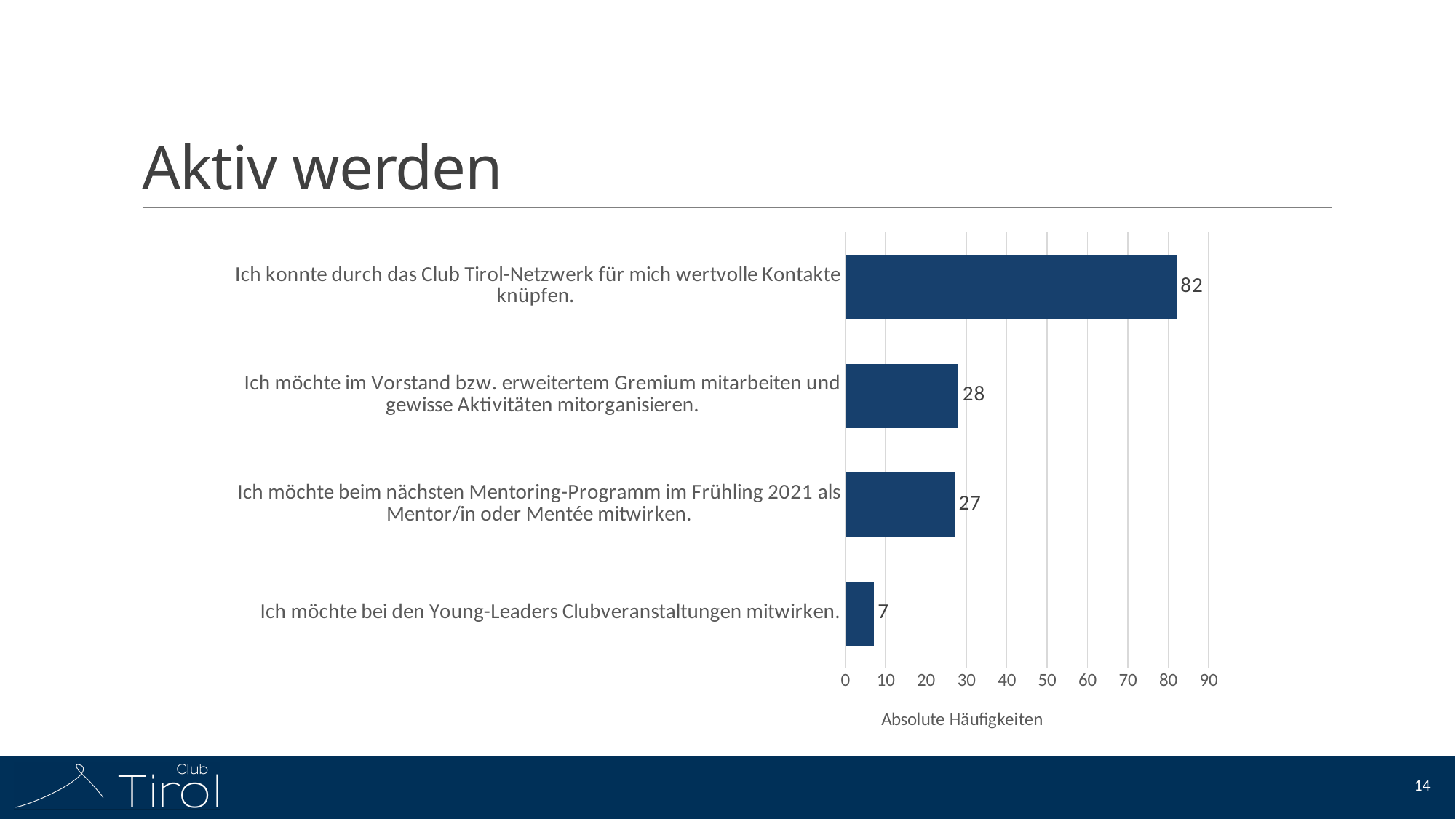
What is the difference between the value for "Ich konnte durch das Club Tirol-Netzwerk für mich wertvolle Kontakte knüpfen." and the value for "Ich möchte bei den Young-Leaders Clubveranstaltungen mitwirken."? 75 What is the value for "Ich konnte durch das Club Tirol-Netzwerk für mich wertvolle Kontakte knüpfen."? 82 How many categories are shown in the chart? 4 What is the value for "Ich möchte bei den Young-Leaders Clubveranstaltungen mitwirken."? 7 What is the value for "Ich möchte im Vorstand bzw. erweitertem Gremium mitarbeiten und gewisse Aktivitäten mitorganisieren."? 28 Which category has the lowest value? Ich möchte bei den Young-Leaders Clubveranstaltungen mitwirken. Which is larger: the value for the Vorstand/Gremium category or the value for the Young-Leaders category? Vorstand/Gremium category What is the difference between the values for the Vorstand/Gremium category and the Mentoring-Programm category? 1 What is the label of the horizontal axis? Absolute Häufigkeiten What kind of chart is shown on the slide? Bar chart Which category has the highest value? Ich konnte durch das Club Tirol-Netzwerk für mich wertvolle Kontakte knüpfen. What is the value for "Ich möchte beim nächsten Mentoring-Programm im Frühling 2021 als Mentor/in oder Mentée mitwirken."? 27